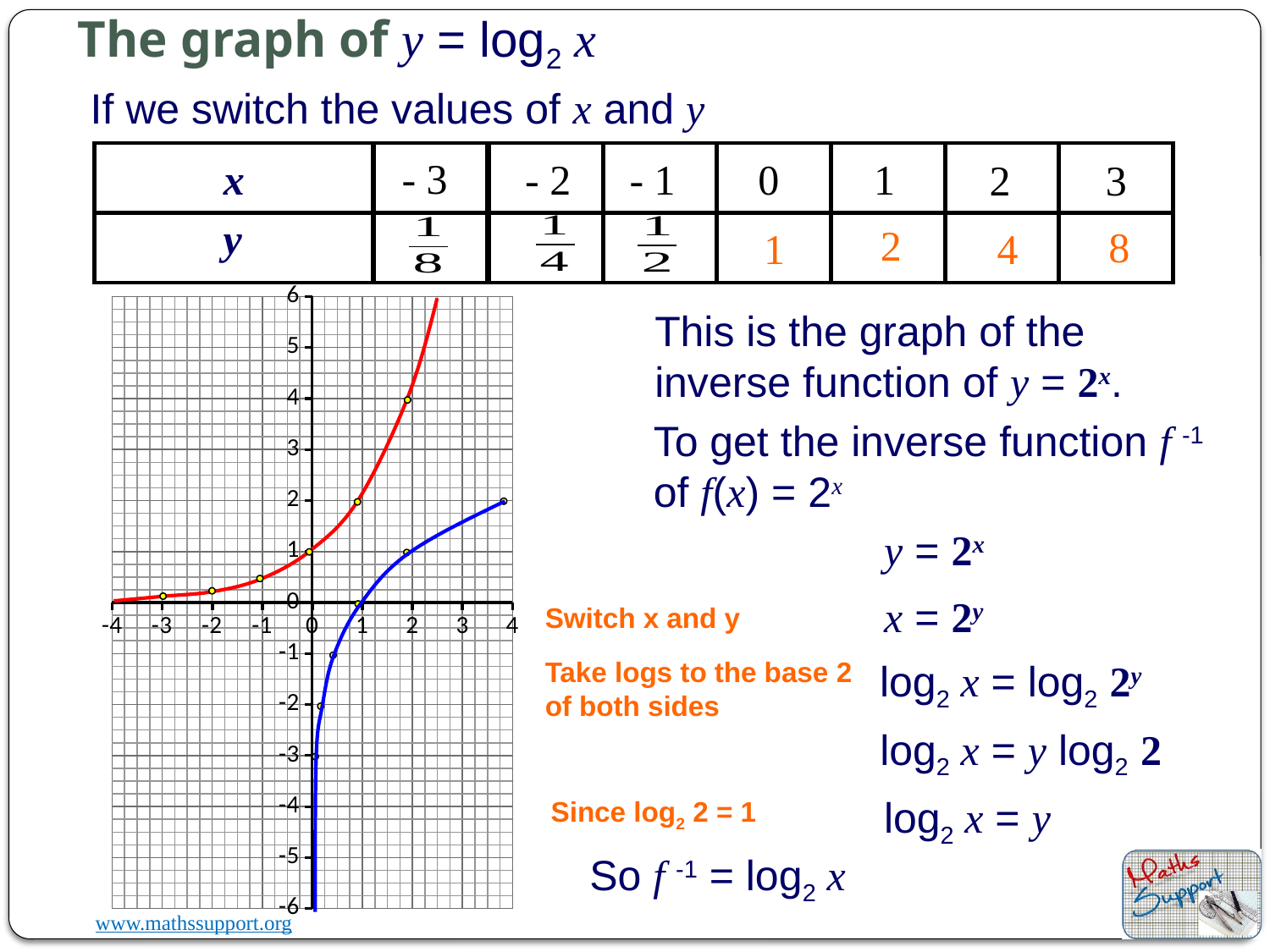
At x = 2, which curve has the higher value, the red curve or the blue curve? red curve What kind of chart is shown on the slide? line chart What is the highest value shown on the y axis of the graph? 6 Is the value of the red curve at x = 2 greater or less than 3? greater According to the table, what is the value of y when x = 0? 1 At what x value does the blue curve cross the x axis? 1 What is the difference between the table's y values at x = 3 and x = 2? 4 Do the values of the blue curve rise or fall as x increases? rise According to the table, what is the value of y when x = -3? 1/8 Do the values of the red curve rise or fall as x increases? rise According to the table, what is the value of y when x = 3? 8 At what y value does the red curve cross the y axis? 1